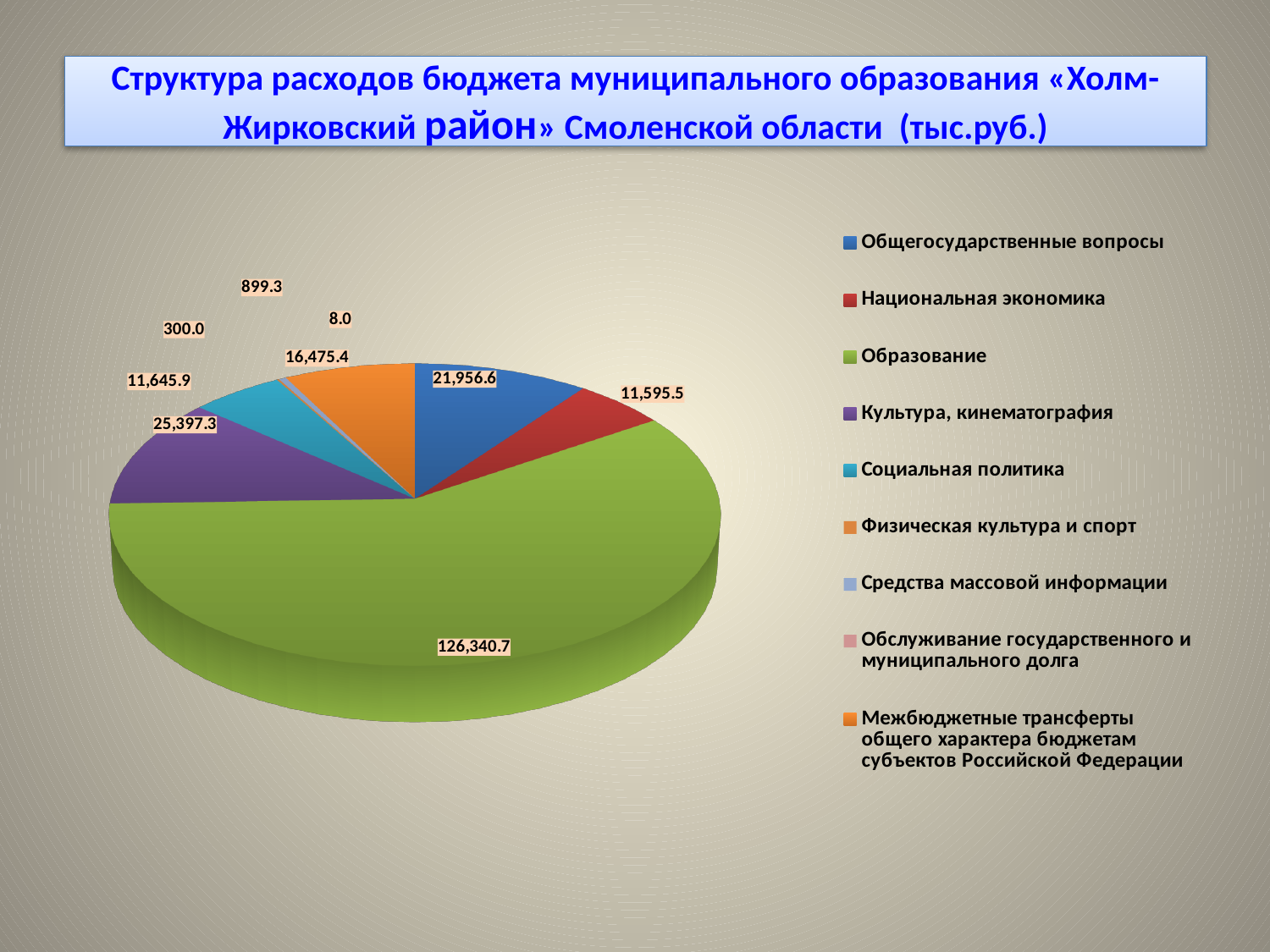
What kind of chart is shown on the slide? Pie chart Which category has the largest slice of the pie? Образование How many categories does the legend of the pie chart list? 9 What is the value for Образование? 126,340.7 What is the difference between the values for Культура, кинематография and Межбюджетные трансферты общего характера бюджетам субъектов Российской Федерации? 8,921.9 What is the difference between the values for Общегосударственные вопросы and Национальная экономика? 10,361.1 Which is larger, the value for Социальная политика or the value for Национальная экономика? Социальная политика What is the value for Межбюджетные трансферты общего характера бюджетам субъектов Российской Федерации? 16,475.4 What is the smallest value shown on the pie chart? 8.0 What is the value for Культура, кинематография? 25,397.3 What unit is stated in the chart title? тыс.руб. What is the value for Общегосударственные вопросы? 21,956.6